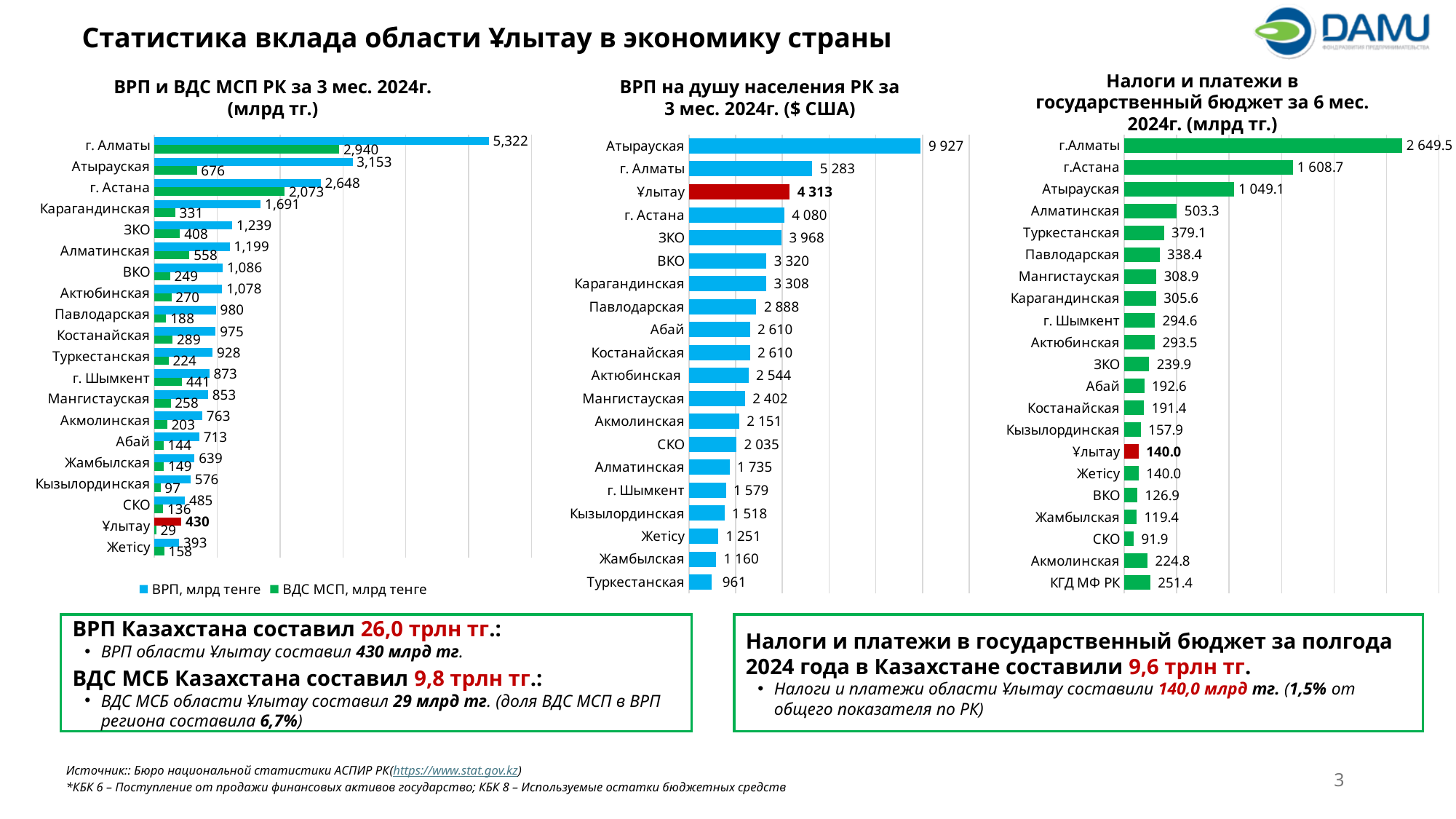
In the chart 'ВРП на душу населения РК за 3 мес. 2024г.', which region has the lowest value? Туркестанская In the chart 'ВРП и ВДС МСП РК за 3 мес. 2024г.', which region has the highest ВРП value? г. Алматы What type of chart is 'Налоги и платежи в государственный бюджет за 6 мес. 2024г.'? Bar chart In the chart 'ВРП и ВДС МСП РК за 3 мес. 2024г.', what is the ВРП value for Ұлытау? 430 In the chart 'ВРП на душу населения РК за 3 мес. 2024г.', which is larger: the value for ЗКО or the value for ВКО? ЗКО In the chart 'ВРП и ВДС МСП РК за 3 мес. 2024г.', what is the ВДС МСП value for г. Астана? 2,073 In the chart 'ВРП и ВДС МСП РК за 3 мес. 2024г.', how many series does the legend list? 2 In the chart 'Налоги и платежи в государственный бюджет за 6 мес. 2024г.', what is the value for г.Астана? 1 608.7 In the chart 'Налоги и платежи в государственный бюджет за 6 мес. 2024г.', which category has the lowest value? СКО In the chart 'ВРП на душу населения РК за 3 мес. 2024г.', what is the value for Ұлытау? 4 313 In the chart 'ВРП на душу населения РК за 3 мес. 2024г.', how many regions are shown? 20 In the chart 'ВРП и ВДС МСП РК за 3 мес. 2024г.', what is the difference between the ВРП values of Атырауская and г. Астана? 505